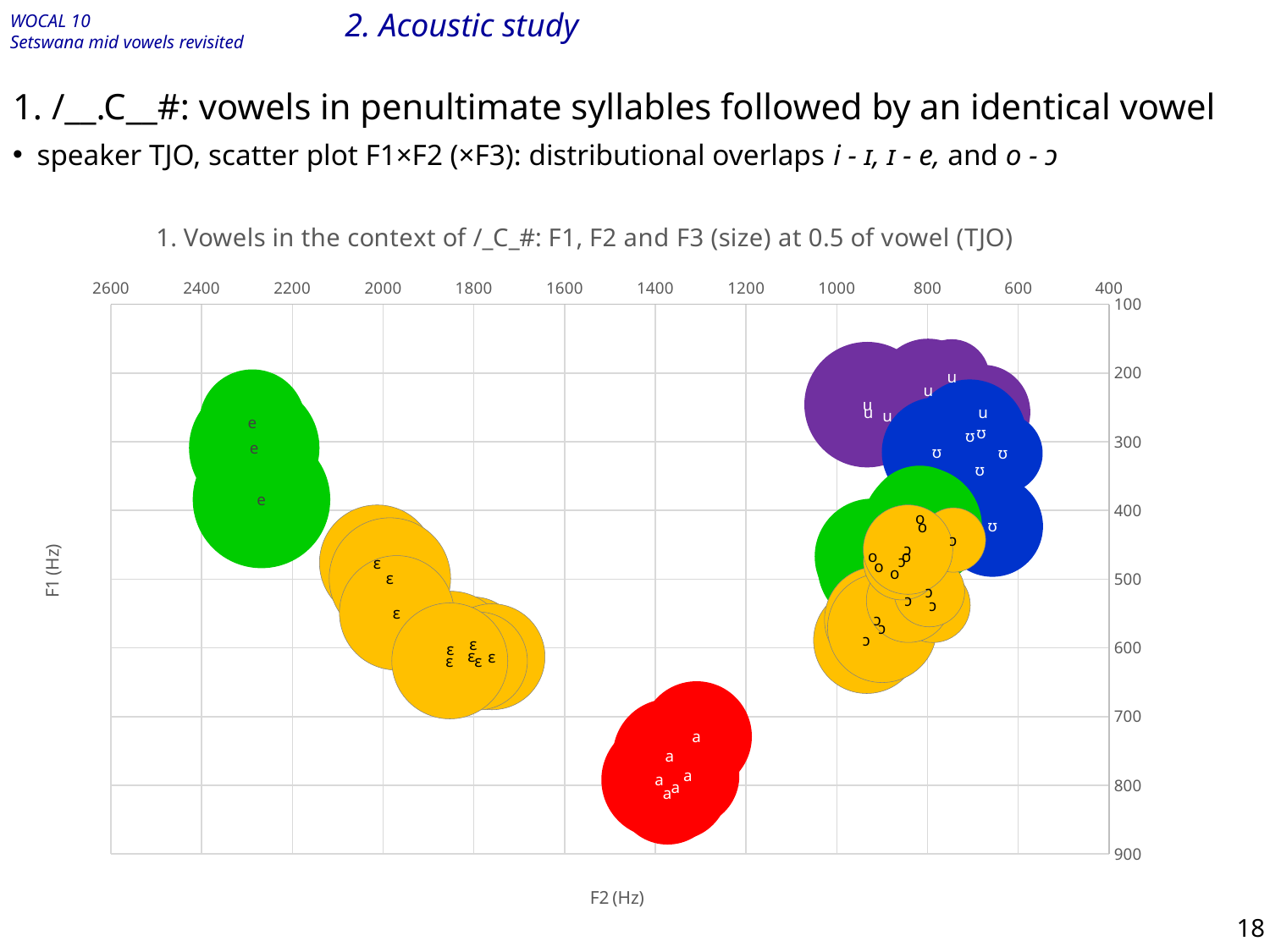
Are the F1 values of the 'u' vowel points greater or less than 300? less How many 'e' vowel points are plotted in the green cluster on the left? 3 What are the labels of the horizontal and vertical axes of the chart? F2 (Hz) and F1 (Hz) Are the F2 values of the 'e' vowel points greater or less than 2200? greater What is the title of the chart? 1. Vowels in the context of /_C_#: F1, F2 and F3 (size) at 0.5 of vowel (TJO) Are the F2 values of the 'a' vowel points greater or less than 1400? less What kind of chart is shown on the slide? bubble (scatter) chart Which vowel has higher F2 values, 'e' or 'u'? e Which vowel has higher F1 values, 'a' or 'e'? a